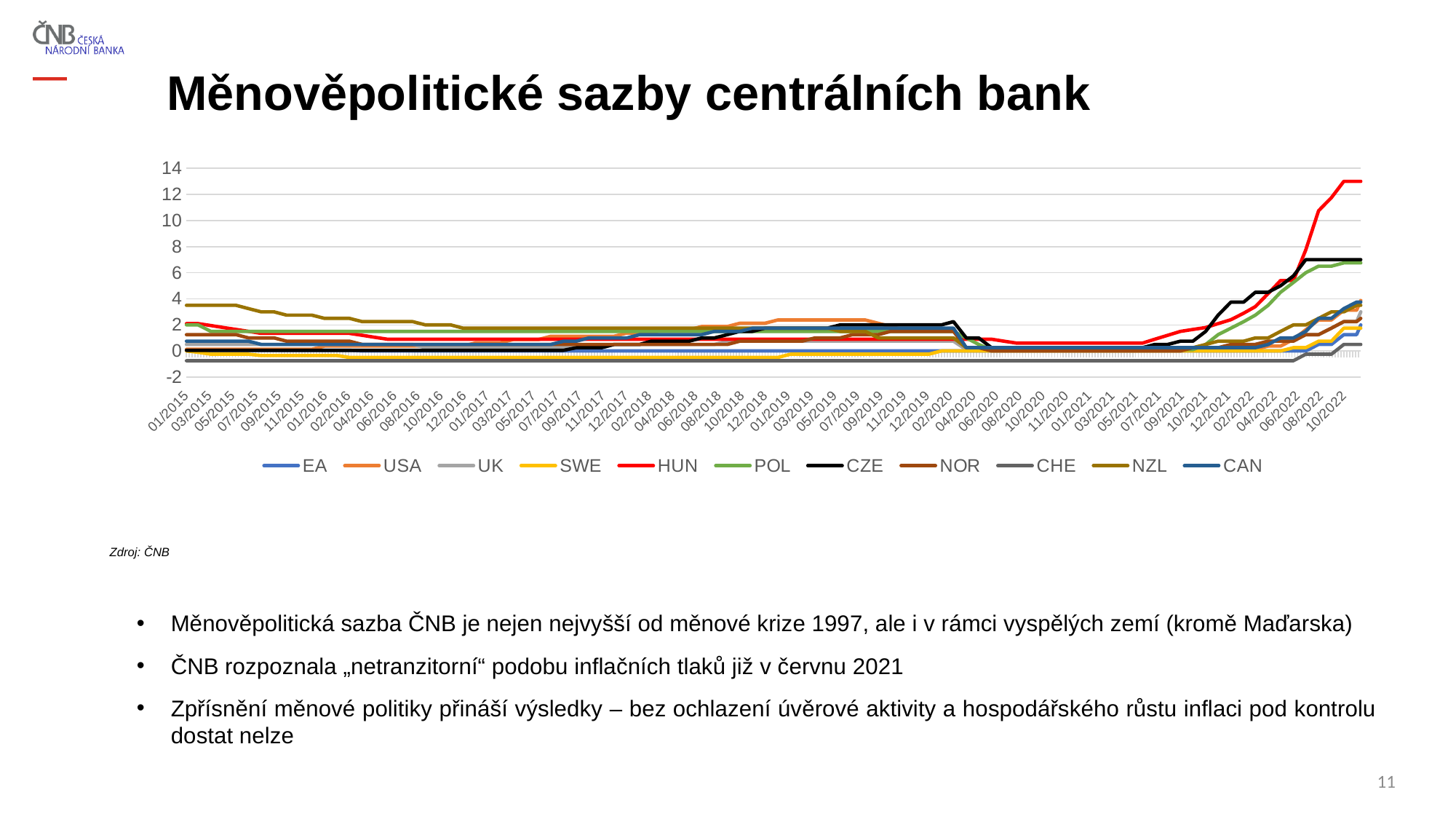
Is the value for HUN at 10/2022 greater or less than 12? greater Is the value for CZE at 10/2022 greater or less than 8? less What is the title of the chart slide? Měnověpolitické sazby centrálních bank Which is larger at 10/2022, the value for HUN or the value for CZE? HUN Does the HUN series rise or fall between 07/2021 and 10/2022? rise How many series does the legend list? 11 Is the value for CZE at 10/2022 greater or less than 6? greater What kind of chart is shown on the slide? line chart Which series has the lowest value at 01/2015? CHE Which is larger at 01/2015, the value for NZL or the value for EA? NZL Which series has the highest value at 10/2022? HUN